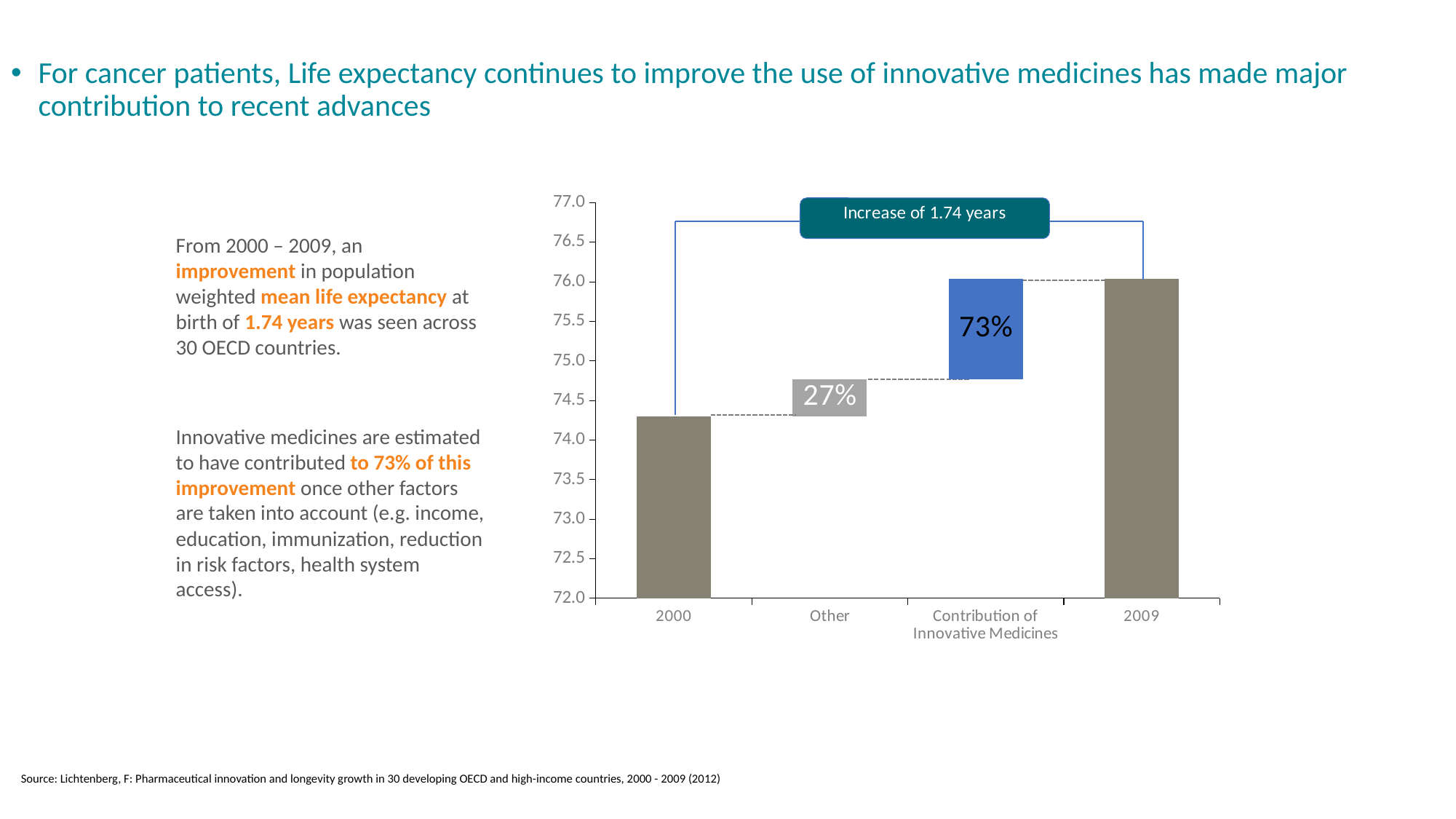
What percentage label is shown on the 'Other' bar? 27% Which bar is taller, 2000 or 2009? 2009 What is the difference in percentage points between the 'Contribution of Innovative Medicines' label and the 'Other' label? 46 percentage points Which has the larger labelled share, 'Other' or 'Contribution of Innovative Medicines'? Contribution of Innovative Medicines How many categories are shown on the x axis of the chart? 4 Is the value of the 2000 bar greater or less than 74.0? greater What percentage label is shown on the 'Contribution of Innovative Medicines' bar? 73% Is the value of the 2000 bar greater or less than 75.0? less What does the annotation box above the chart say? Increase of 1.74 years Is the value of the 2009 bar greater or less than 75.0? greater Do the values rise or fall from 2000 to 2009 along the x axis? rise What kind of chart is shown on the slide? bar chart